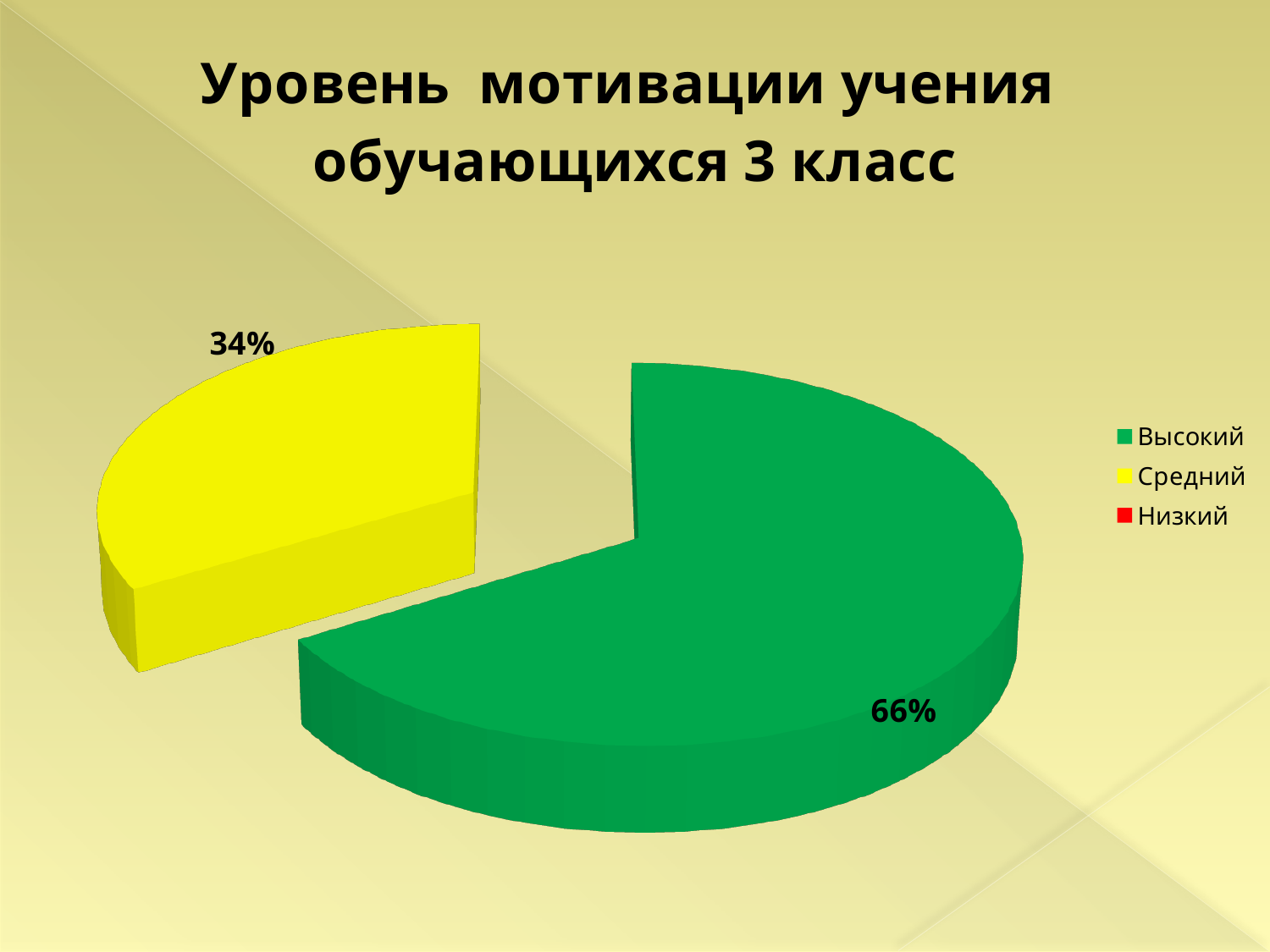
What share of the pie does the Средний slice represent? 34% Which is larger, the Высокий slice or the Средний slice? Высокий Of the two slices with printed labels, which is the smaller one? Средний What colour represents the Высокий category in the chart? Green Which category has the largest slice of the pie? Высокий By how many percentage points does the Высокий slice exceed the Средний slice? 32% What kind of chart is shown on the slide? Pie chart What percentage of the pie is labelled for the Высокий category? 66% How many entries does the chart legend list? 3 What percentage of the pie is labelled for the Средний category? 34% What do the two labelled slices (Высокий and Средний) add up to? 100% What is the title of the slide? Уровень мотивации учения обучающихся 3 класс